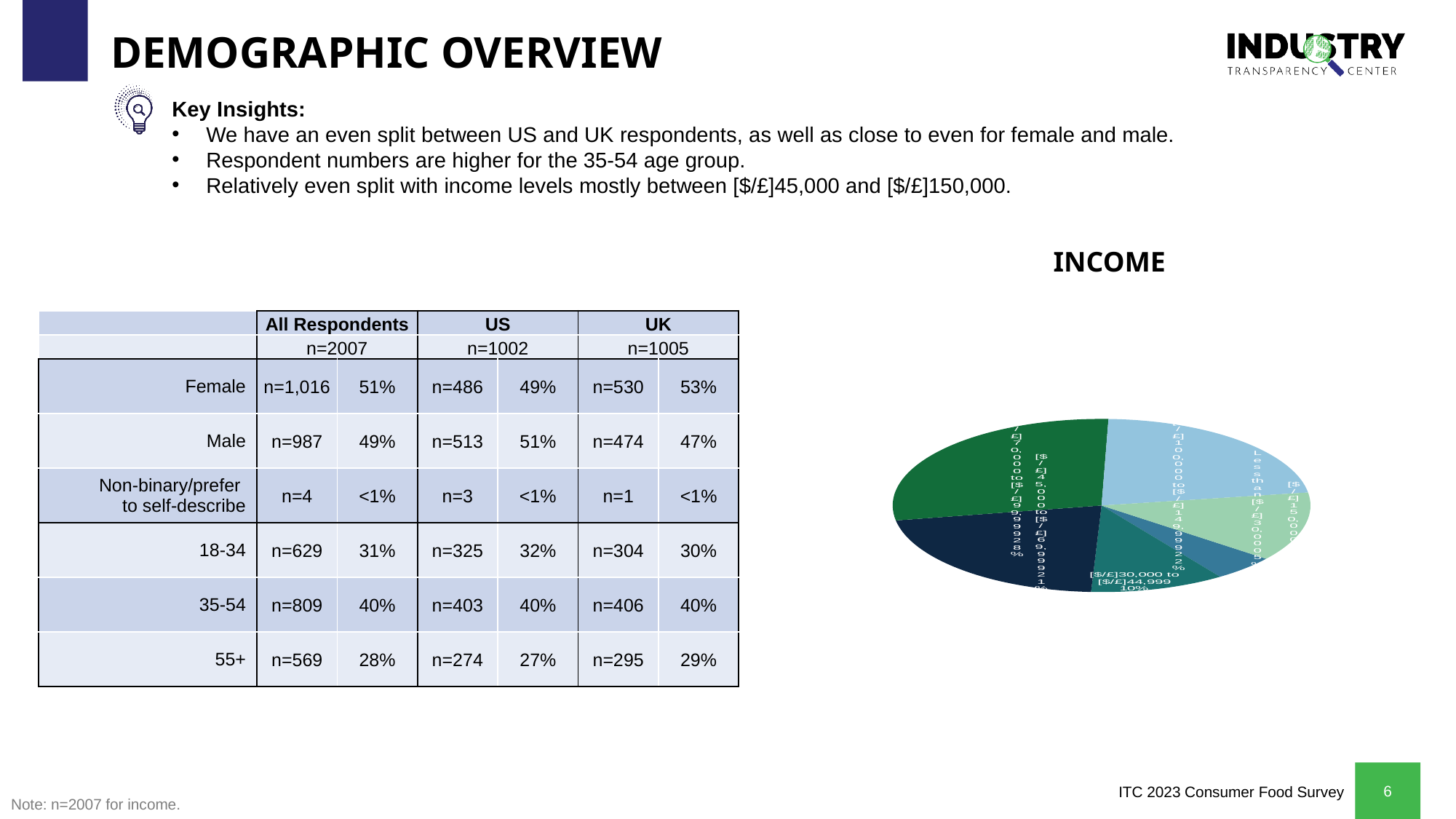
What is the title of the chart on the right side of the slide? INCOME In the INCOME pie chart, what share of respondents falls in the [$/£]30,000 to [$/£]44,999 income band? 10% How many slices does the INCOME pie chart have? 6 What kind of chart is the INCOME chart on the slide? pie chart According to the note on the slide, what is the sample size (n) for the INCOME chart? n=2007